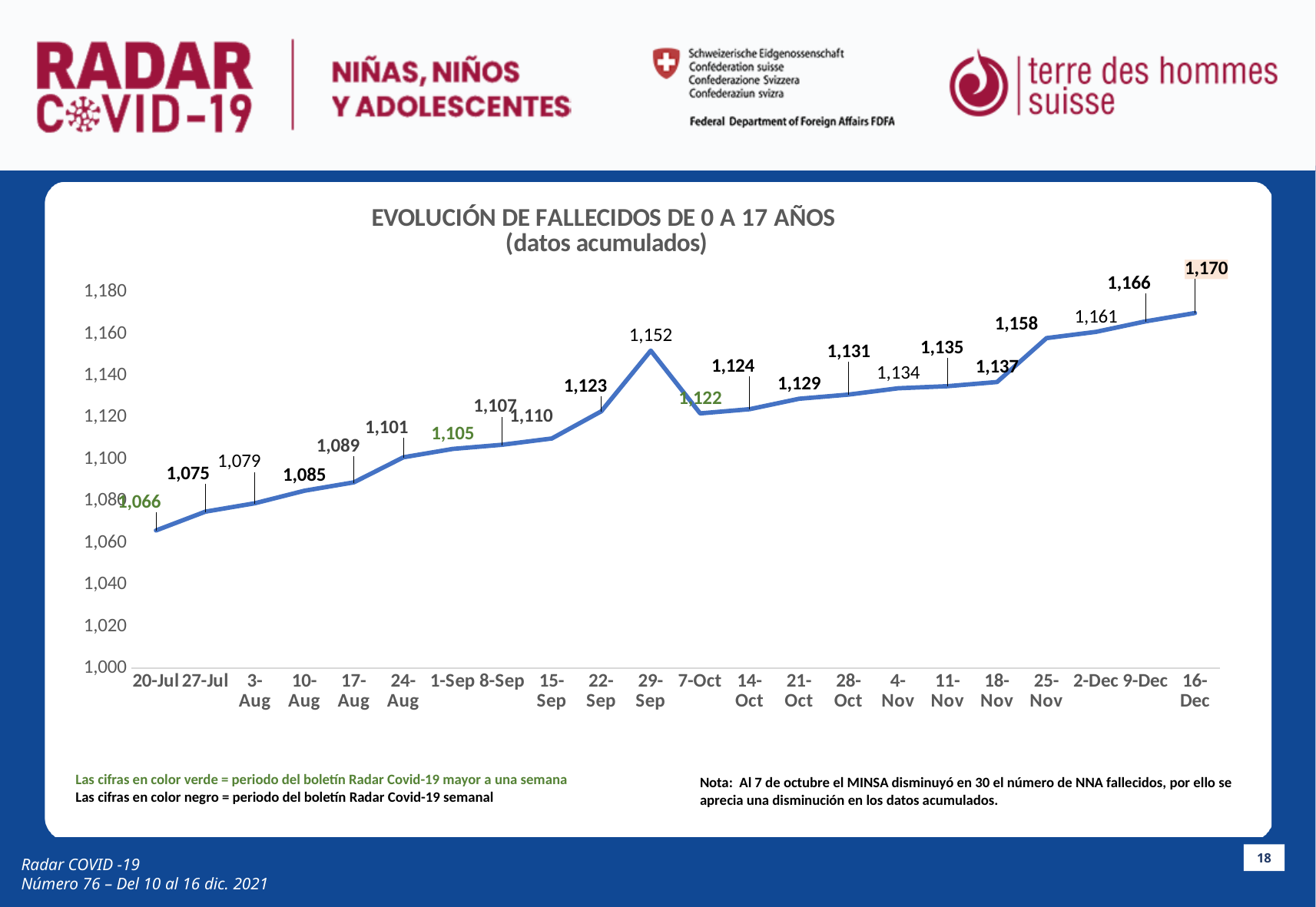
What is the cumulative value shown for 29-Sep? 1,152 By how much does the value drop from 29-Sep to 7-Oct? 30 Which date has the lowest value on the chart? 20-Jul What is the value shown for 7-Oct? 1,122 What is the value shown for 20-Jul? 1,066 How many data points are plotted on the line? 22 Which is larger, the value for 29-Sep or the value for 14-Oct? 29-Sep Which date has the highest value on the chart? 16-Dec What is the difference between the values for 16-Dec and 20-Jul? 104 Is the value for 25-Nov greater or less than 1,140? greater What type of chart is shown on the slide? line chart What is the value plotted for 16-Dec? 1,170